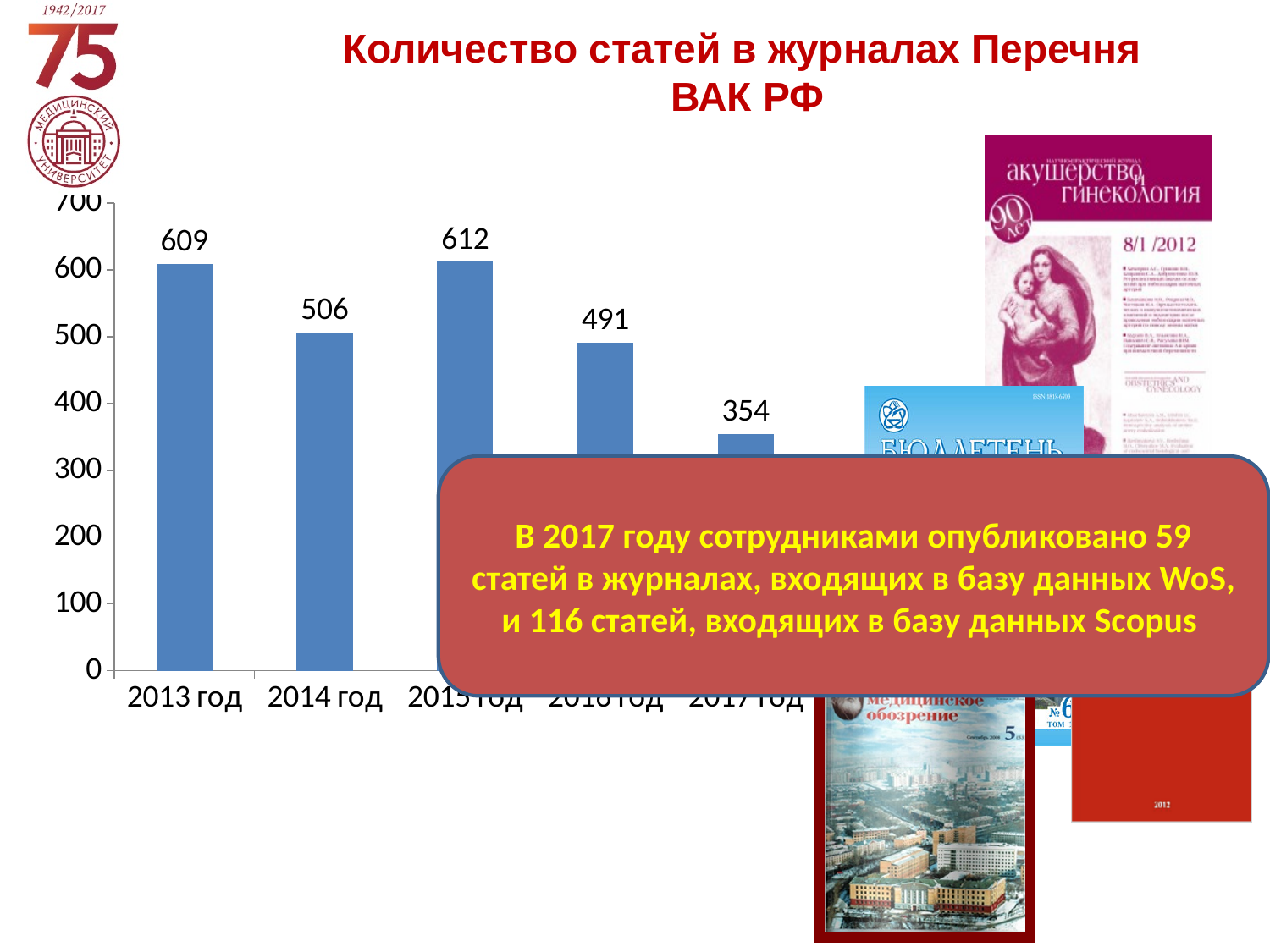
What is the value for 2015 год? 612 What is the value for 2017 год? 354 What is the difference between the values for 2013 год and 2014 год? 103 Which year has the lowest value? 2017 год What is the value for 2014 год? 506 What is the value for 2013 год? 609 What is the value for 2016 год? 491 What kind of chart is shown on the slide? Bar chart How many years are shown on the x axis? 5 Which is larger, the value for 2014 год or the value for 2016 год? 2014 год What is the title of the slide? Количество статей в журналах Перечня ВАК РФ Which year has the highest value? 2015 год